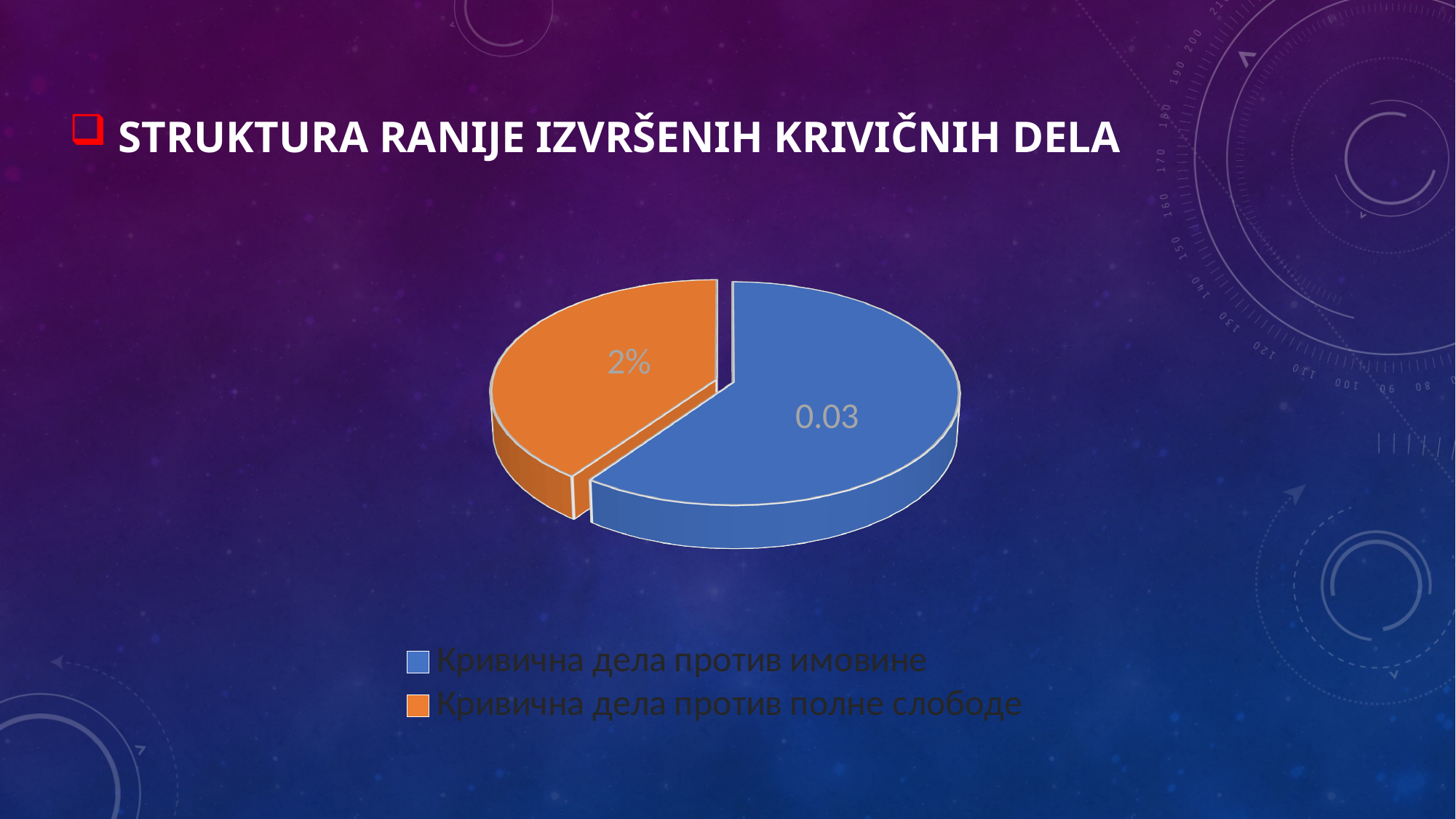
What colour is the slice for Кривична дела против полне слободе? orange How many slices does the pie chart have? 2 Which slice is larger: Кривична дела против имовине or Кривична дела против полне слободе? Кривична дела против имовине What kind of chart is shown on the slide? pie chart How many entries does the legend of the pie chart list? 2 Which category has the smallest slice in the pie chart? Кривична дела против полне слободе What is the title of the slide containing the pie chart? STRUKTURA RANIJE IZVRŠENIH KRIVIČNIH DELA What label is printed on the slice for Кривична дела против имовине? 0.03 Which category has the largest slice in the pie chart? Кривична дела против имовине What label is printed on the slice for Кривична дела против полне слободе? 2%